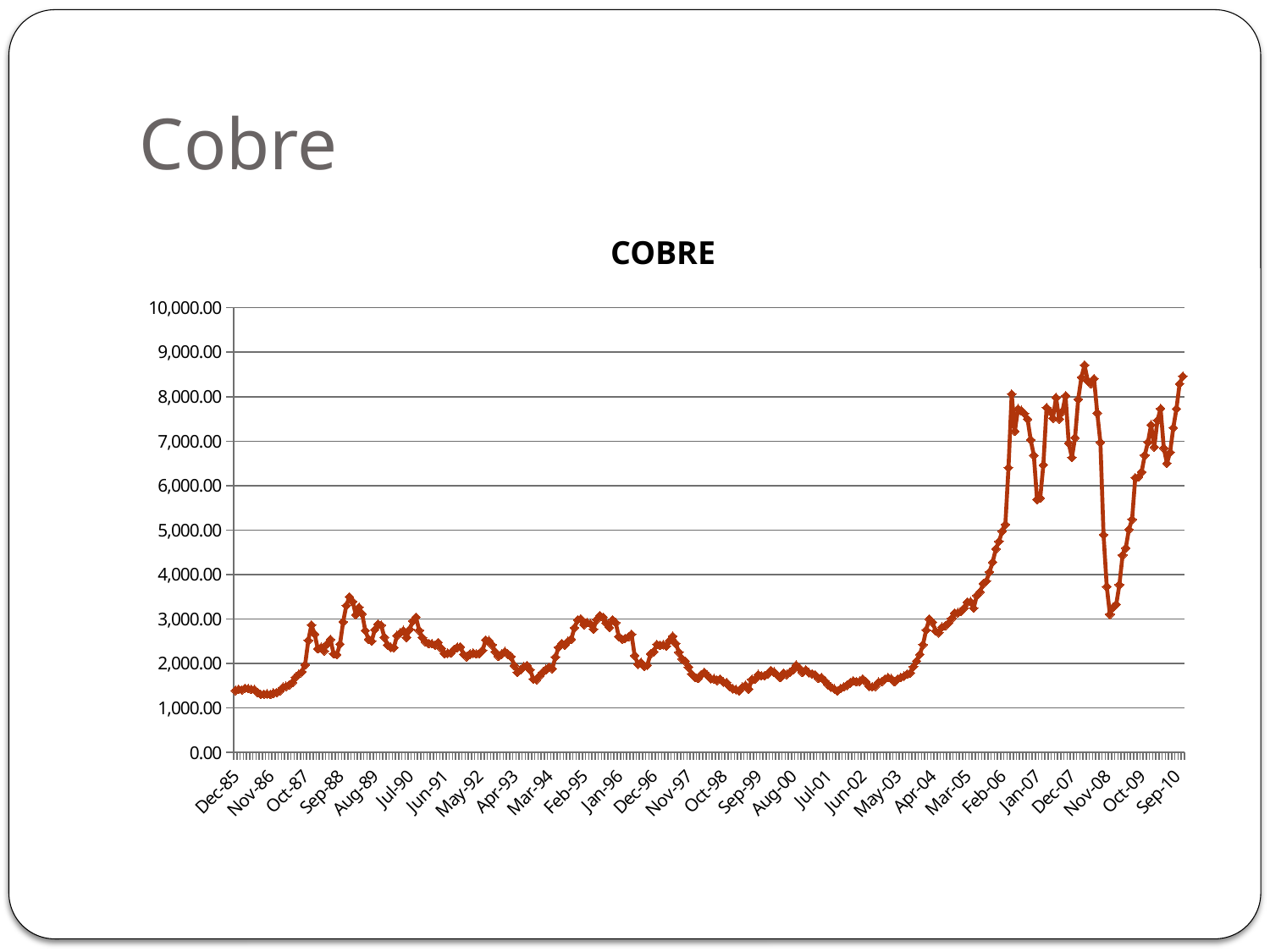
Is the value at Mar-05 greater or less than 4,000.00? less What kind of chart is shown on the slide? line chart Is the final plotted value at the right end of the chart greater or less than 8,000.00? greater Does the line generally rise or fall between Dec-85 and Sep-88? rise What is the highest value shown on the vertical axis? 10,000.00 Does the line generally rise or fall between May-03 and Feb-06? rise Does the line generally rise or fall between Jan-96 and Oct-98? fall Is the highest peak of the line greater or less than 8,000.00? greater What is the title of the chart? COBRE